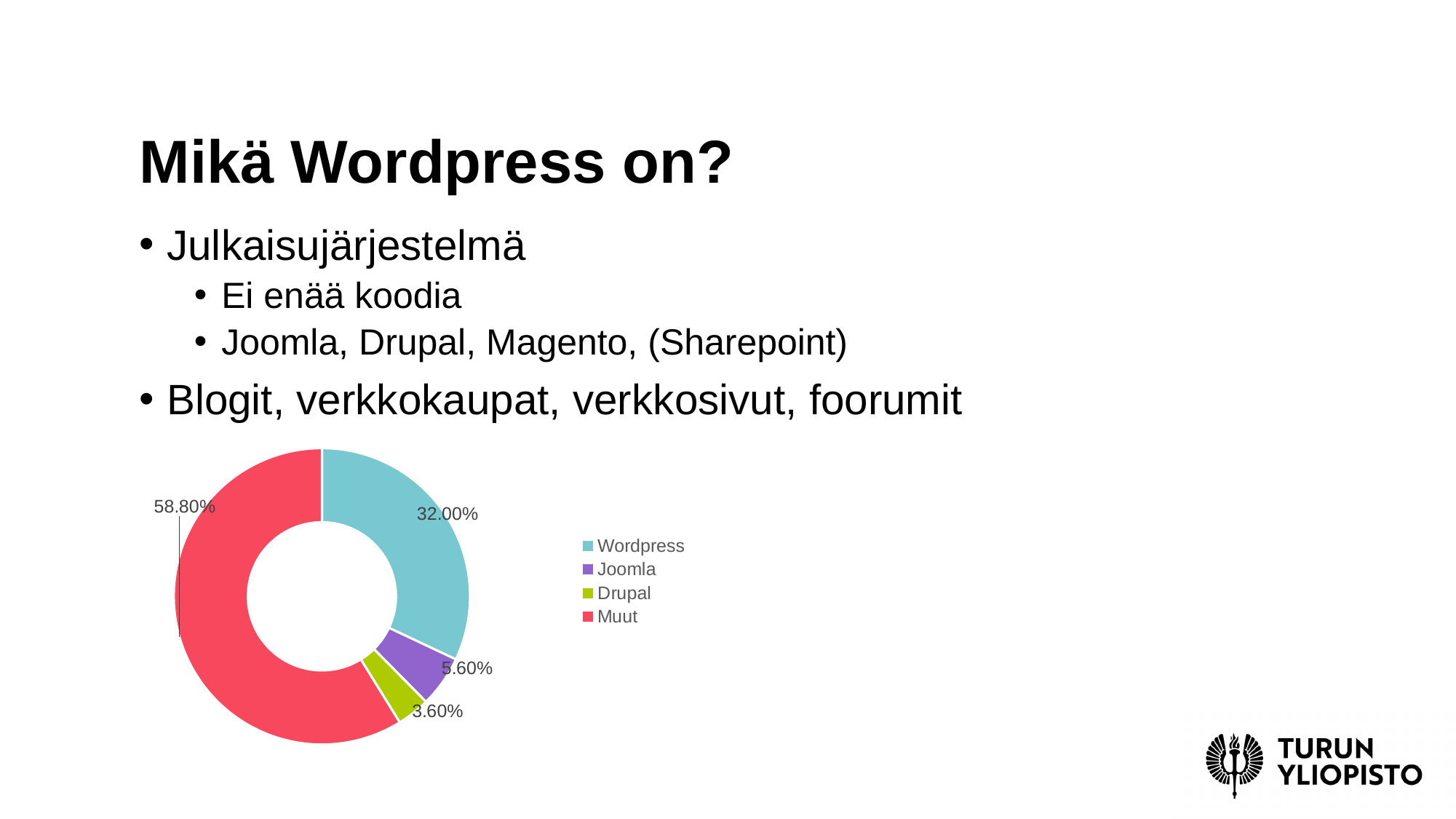
Which category has the largest share in the chart? Muut Which colour represents Drupal in the chart? Green What share of the doughnut chart does Drupal have? 3.60% Which category has the smallest share in the chart? Drupal What share of the doughnut chart does Joomla have? 5.60% What kind of chart is shown on the slide? Doughnut (pie) chart How many categories are shown in the chart? 4 Which has a larger share, Wordpress or Joomla? Wordpress What is the difference between the shares of Joomla and Drupal? 2.00% What share of the doughnut chart does Muut have? 58.80% What is the difference between the shares of Muut and Wordpress? 26.80% What share of the doughnut chart does Wordpress have? 32.00%